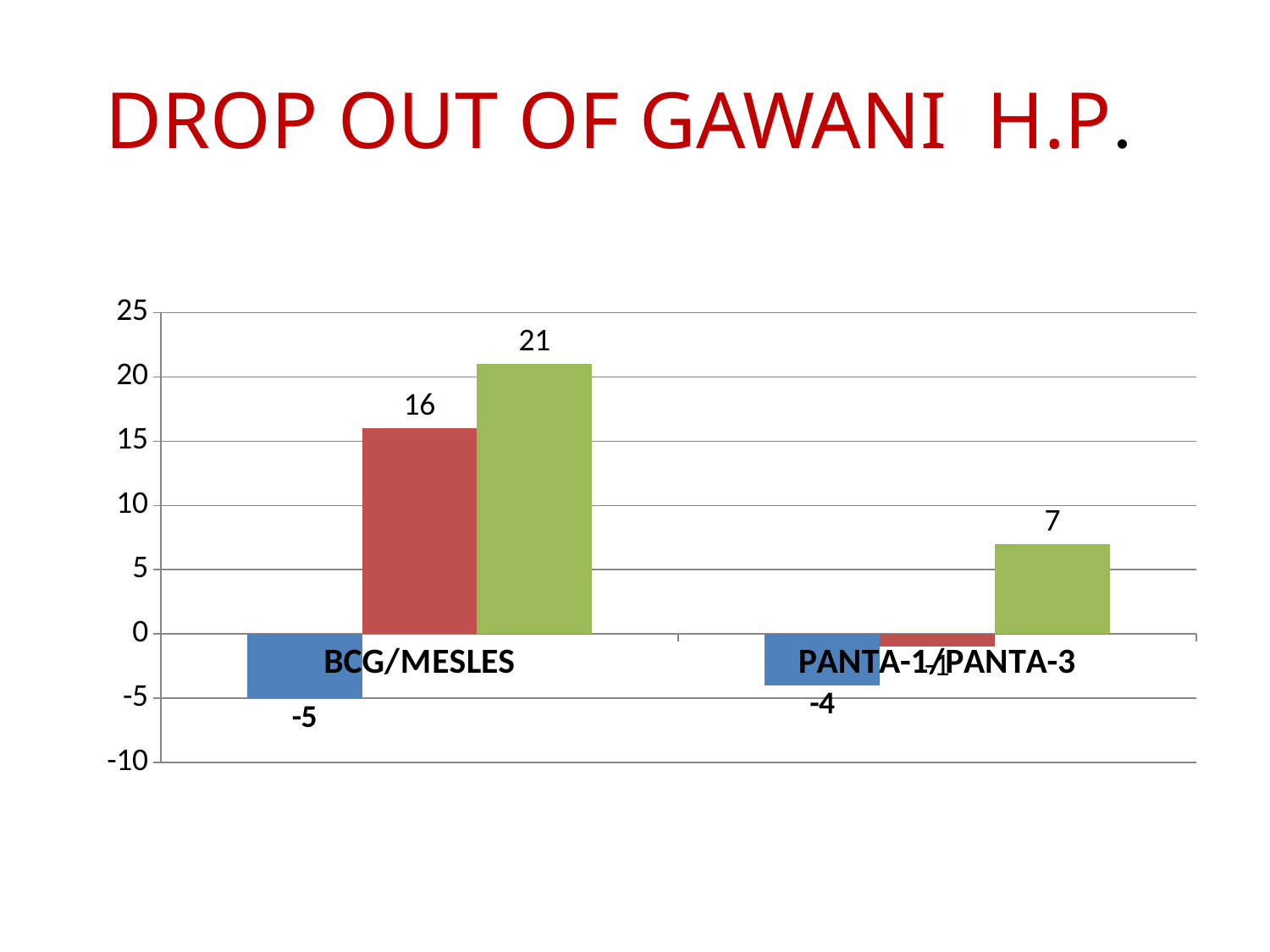
What is the difference between the green bar and the red bar for BCG/MESLES? 5 What is the difference between the green bar for BCG/MESLES and the green bar for PANTA-1/PANTA-3? 14 What is the value of the green bar for BCG/MESLES? 21 Which bar has the highest value in the chart? the green bar for BCG/MESLES (21) Which category has the larger green bar, BCG/MESLES or PANTA-1/PANTA-3? BCG/MESLES What is the value of the blue bar for BCG/MESLES? -5 What kind of chart is shown on the slide? bar chart What is the value of the red bar for BCG/MESLES? 16 What is the value of the green bar for PANTA-1/PANTA-3? 7 How many categories are shown on the x axis of the chart? 2 What is the title of the slide? DROP OUT OF GAWANI H.P. What is the value of the blue bar for PANTA-1/PANTA-3? -4